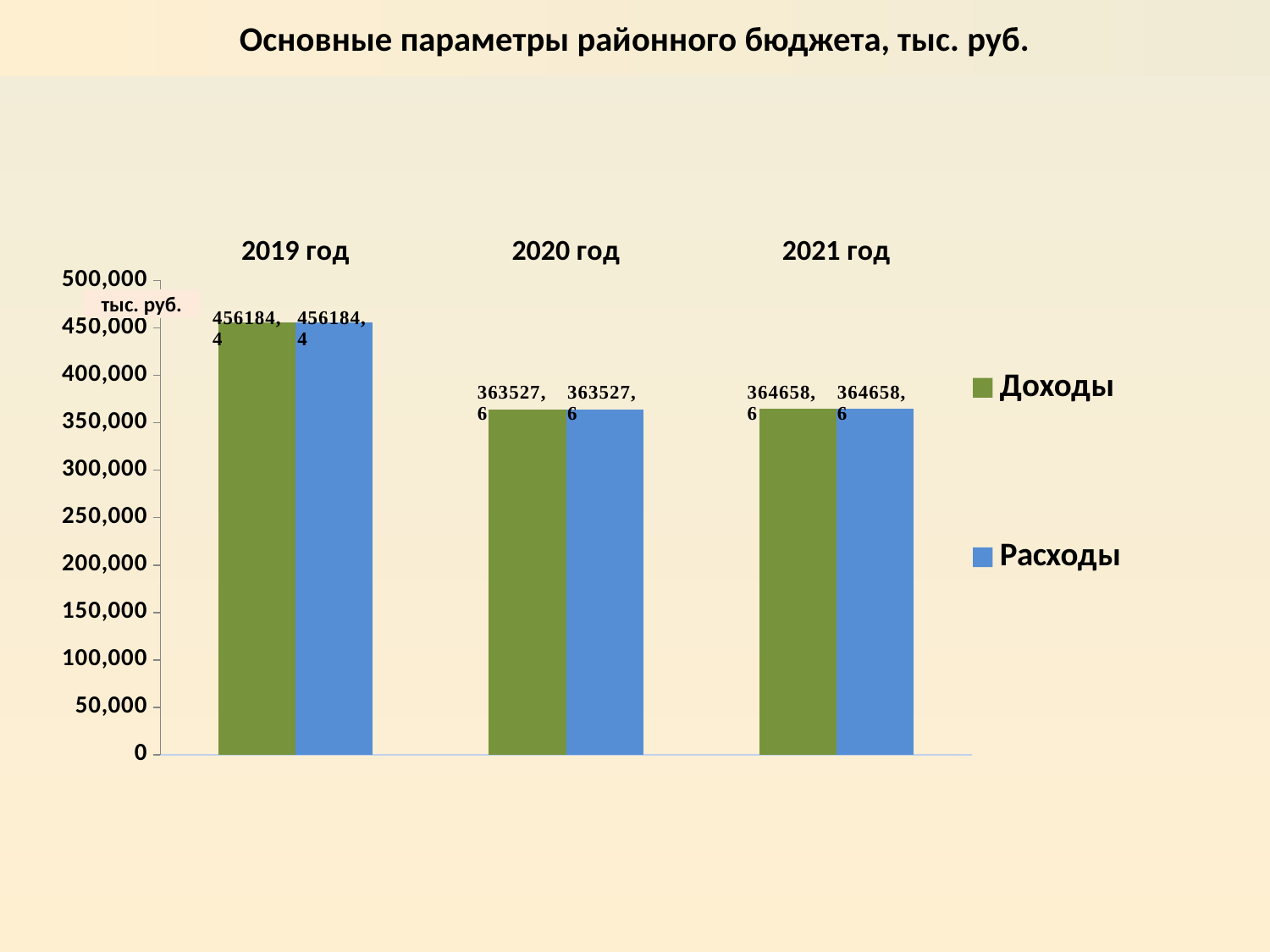
What is the value of Доходы for 2019 год? 456184,4 Which is larger: Расходы in 2021 год or Расходы in 2020 год? 2021 год How many series does the legend list? 2 What kind of chart is shown on the slide? bar chart What is the value of Доходы for 2021 год? 364658,6 Is the value of Доходы for 2020 год greater or less than 400,000? less Which year has the highest value of Расходы? 2019 год Which colour represents Расходы in the legend? blue How many years are shown on the x axis? 3 Which year has the lowest value of Доходы? 2020 год What is the value of Расходы for 2020 год? 363527,6 What is the difference between Доходы in 2019 год and Доходы in 2020 год? 92656,8